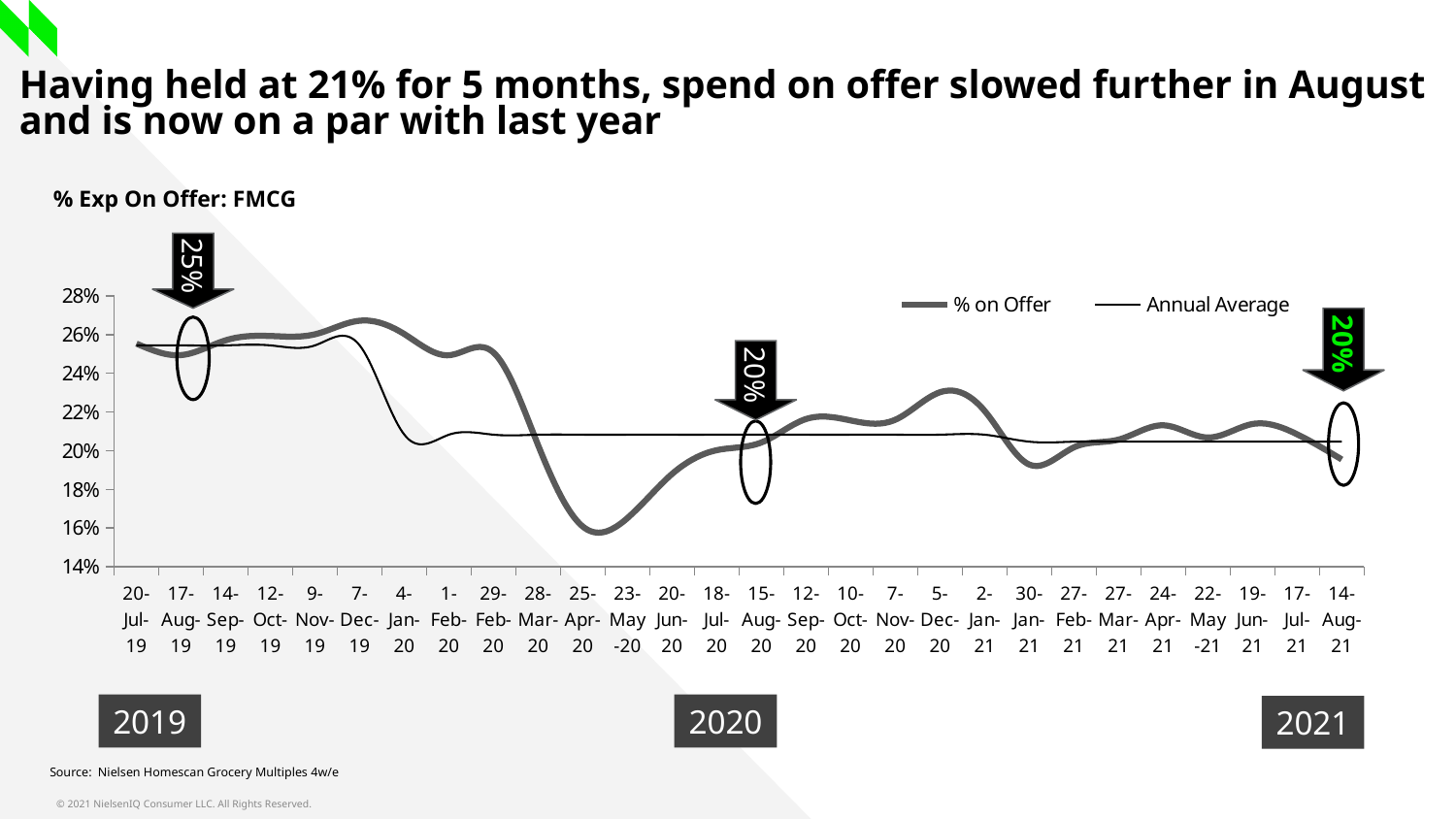
What is the title of the chart? % Exp On Offer: FMCG How many dates are shown along the x axis of the chart? 28 What are the two series named in the chart legend? % on Offer and Annual Average According to the callout, what was the % on Offer value at 17-Aug-19? 25% How many series does the chart legend list? 2 Does the % on Offer line rise or fall between 7-Dec-19 and 25-Apr-20? Fall At which date does the % on Offer line reach its lowest point? 25-Apr-20 By how many percentage points did the annotated % on Offer value fall from 17-Aug-19 (25%) to 15-Aug-20 (20%)? 5 percentage points What type of chart is shown on the slide? Line chart According to the callout, what was the % on Offer value at 15-Aug-20? 20% Is the % on Offer value at 25-Apr-20 greater or less than 18%? less According to the callout, what was the % on Offer value at 14-Aug-21? 20%